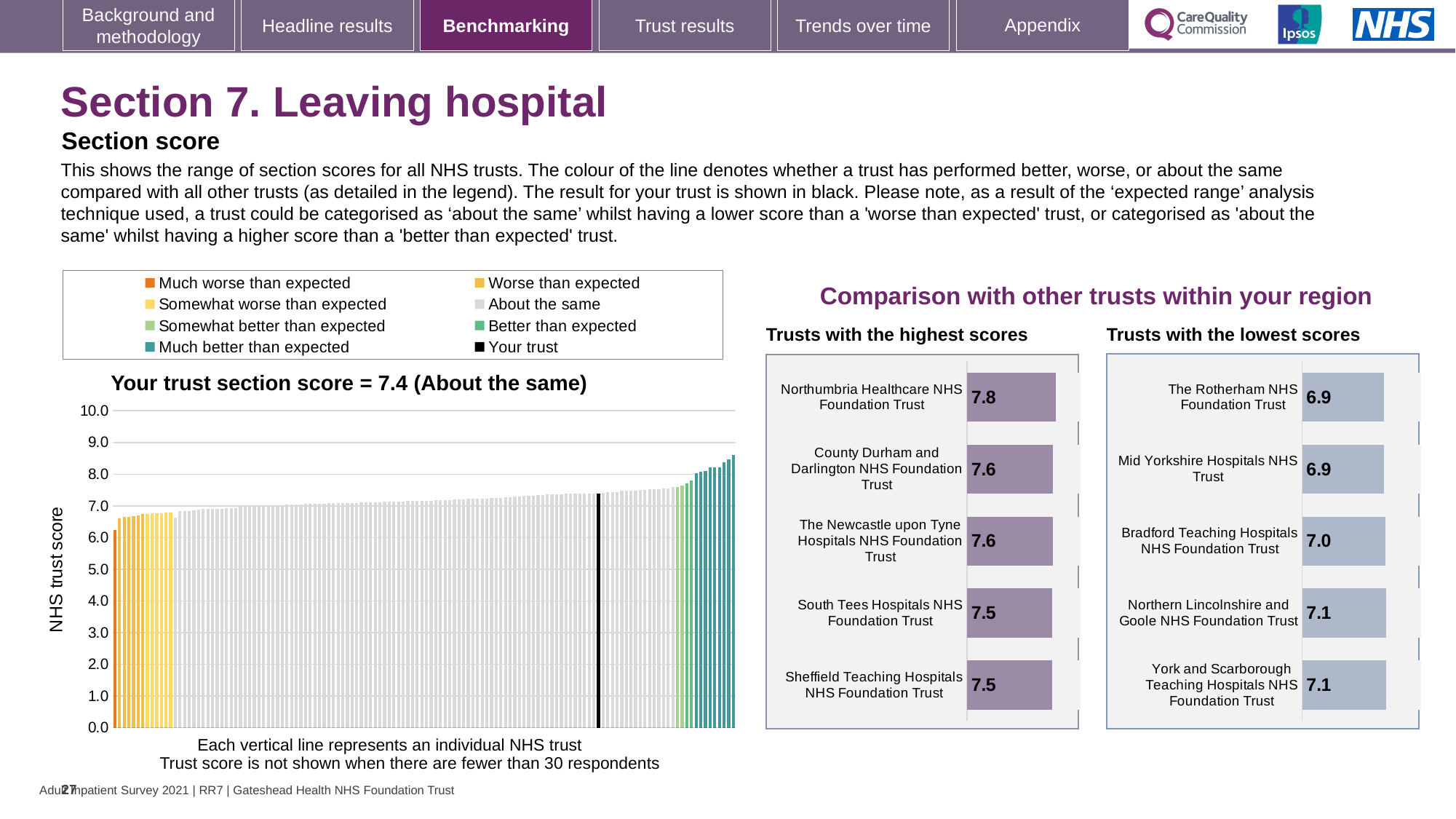
In the 'Your trust section score' chart, what is the section score for your trust? 7.4 How many trusts are shown in the 'Trusts with the lowest scores' chart? 5 How many entries does the legend above the 'Your trust section score' chart list? 8 In the 'Your trust section score' chart, is the value of the tallest bar greater or less than 8.0? greater What kind of chart is the 'Your trust section score' chart? bar chart In the 'Trusts with the lowest scores' chart, what is the score for Bradford Teaching Hospitals NHS Foundation Trust? 7.0 In the 'Trusts with the highest scores' chart, what is the difference between the scores of Northumbria Healthcare NHS Foundation Trust and Sheffield Teaching Hospitals NHS Foundation Trust? 0.3 What is the y-axis label of the 'Your trust section score' chart? NHS trust score In the 'Your trust section score' chart, do the bar values rise or fall from left to right along the x axis? rise In the 'Trusts with the highest scores' chart, what is the score for Northumbria Healthcare NHS Foundation Trust? 7.8 In the 'Trusts with the lowest scores' chart, which has the larger score: Bradford Teaching Hospitals NHS Foundation Trust or The Rotherham NHS Foundation Trust? Bradford Teaching Hospitals NHS Foundation Trust In the 'Trusts with the highest scores' chart, which trust has the highest score? Northumbria Healthcare NHS Foundation Trust